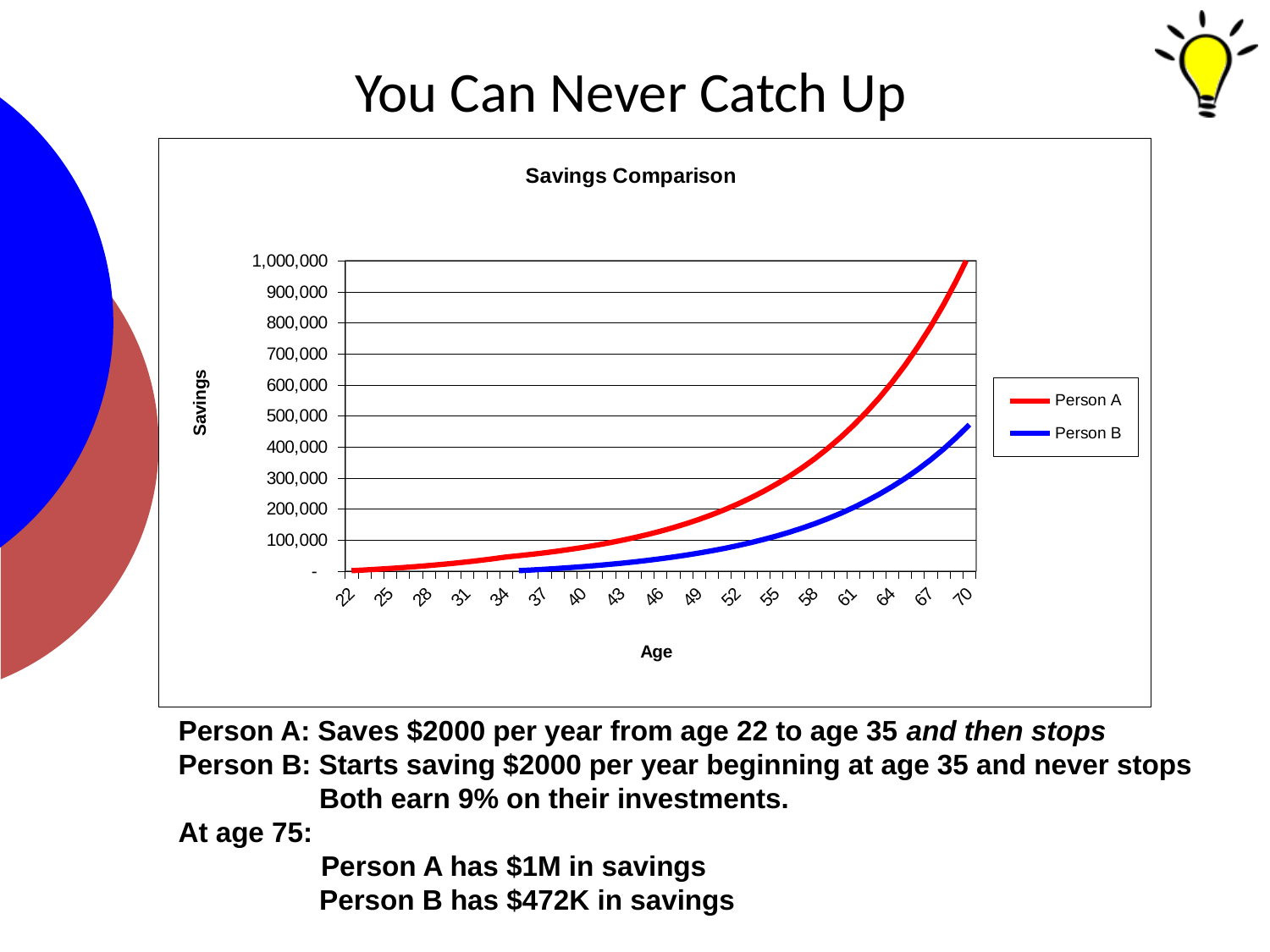
What is the title of the chart on the slide? Savings Comparison What kind of chart is the Savings Comparison chart? line chart How many age labels are shown on the x axis of the Savings Comparison chart? 17 At age 70, which series has the higher savings, Person A or Person B? Person A Which series begins at a later age on the Savings Comparison chart, Person A or Person B? Person B Is the value for Person A at age 61 greater or less than 400,000? greater Do the savings for Person A rise or fall as age increases along the x axis? rise What is the label of the x axis of the Savings Comparison chart? Age Is the value for Person B at age 64 greater or less than 300,000? less Is the value for Person A at age 49 greater or less than 200,000? less How many series does the legend of the Savings Comparison chart list? 2